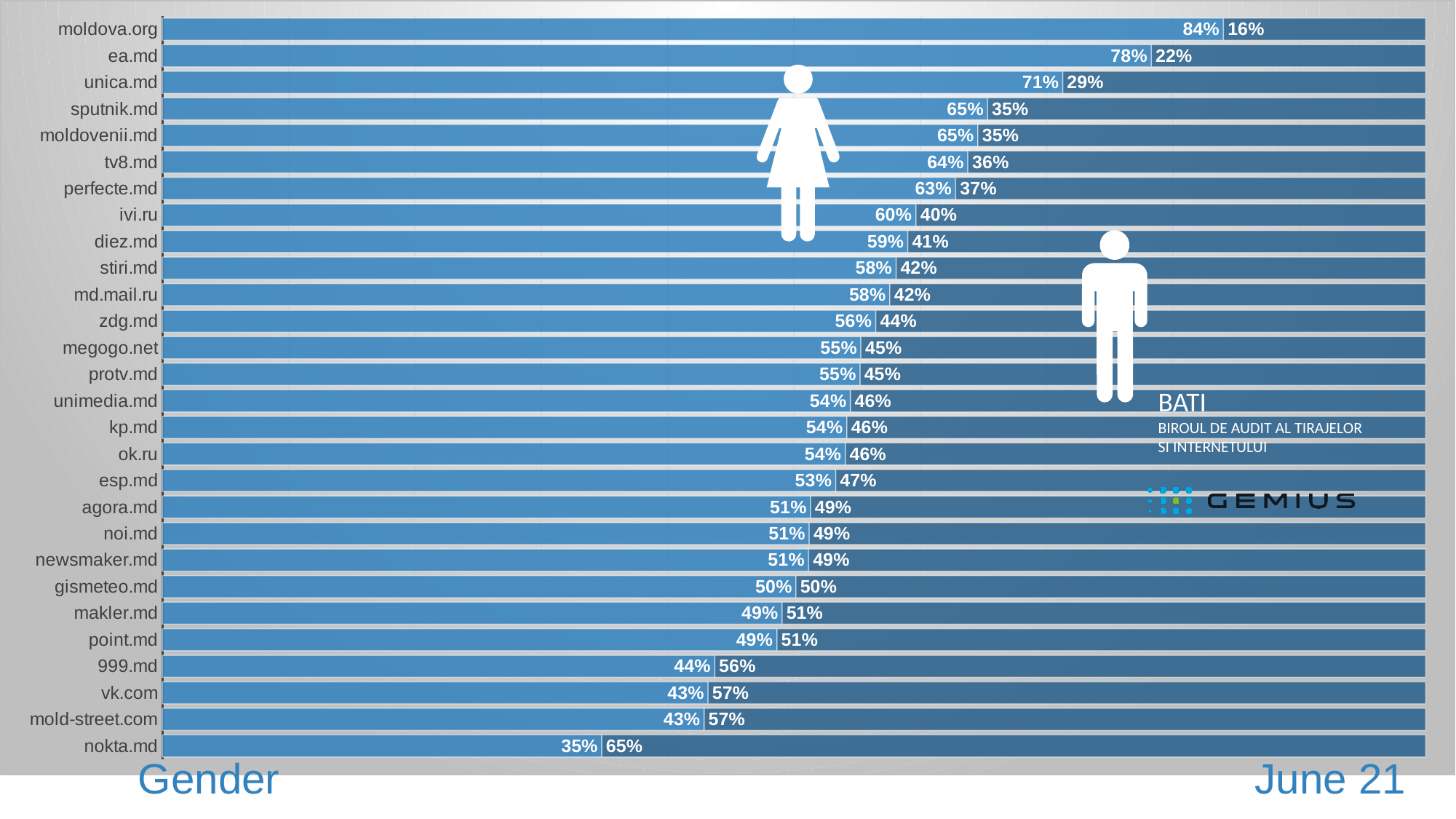
What is the female share (left, lighter segment) shown for moldova.org? 84% Which website has the lowest female share (left, lighter segment)? nokta.md What kind of chart is shown on the slide? Stacked horizontal bar chart What is the title shown at the bottom left of the chart? Gender How many websites are listed in the chart? 28 Which website has the highest female share (left, lighter segment)? moldova.org What are the two values shown for gismeteo.md? 50% and 50% Going down the list from moldova.org to nokta.md, do the left (lighter segment) values rise or fall? Fall For moldova.org, what is the difference between the left value (84%) and the right value (16%)? 68 percentage points Which has the larger left (lighter segment) value, ea.md or unica.md? ea.md What is the male share (right, darker segment) shown for nokta.md? 65% What is the total of the two segments for the moldova.org bar (84% and 16%)? 100%